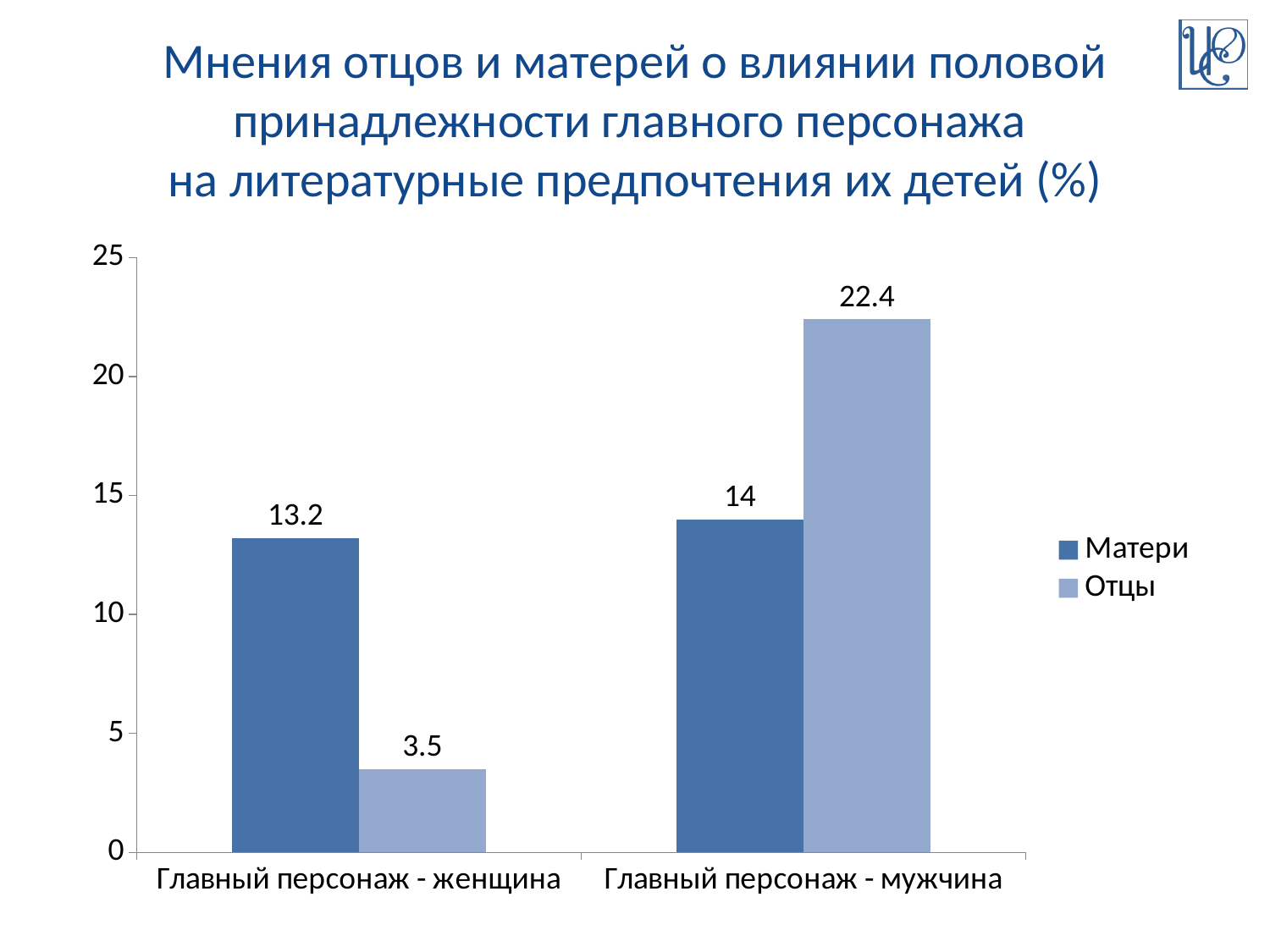
What is the value for Отцы in the category Главный персонаж - мужчина? 22.4 What kind of chart is shown on the slide? bar chart Which bar has the lowest value on the chart? Отцы, Главный персонаж - женщина What is the value for Отцы in the category Главный персонаж - женщина? 3.5 Which is larger: the Матери value for Главный персонаж - женщина or the Отцы value for Главный персонаж - женщина? Матери Is the value for Отцы in the category Главный персонаж - мужчина greater or less than 20? greater What is the value for Матери in the category Главный персонаж - женщина? 13.2 How many categories are shown on the x axis? 2 How many series does the legend list? 2 Which series has the highest value in the category Главный персонаж - мужчина? Отцы What is the difference between the Отцы and Матери values in the category Главный персонаж - мужчина? 8.4 What is the value for Матери in the category Главный персонаж - мужчина? 14